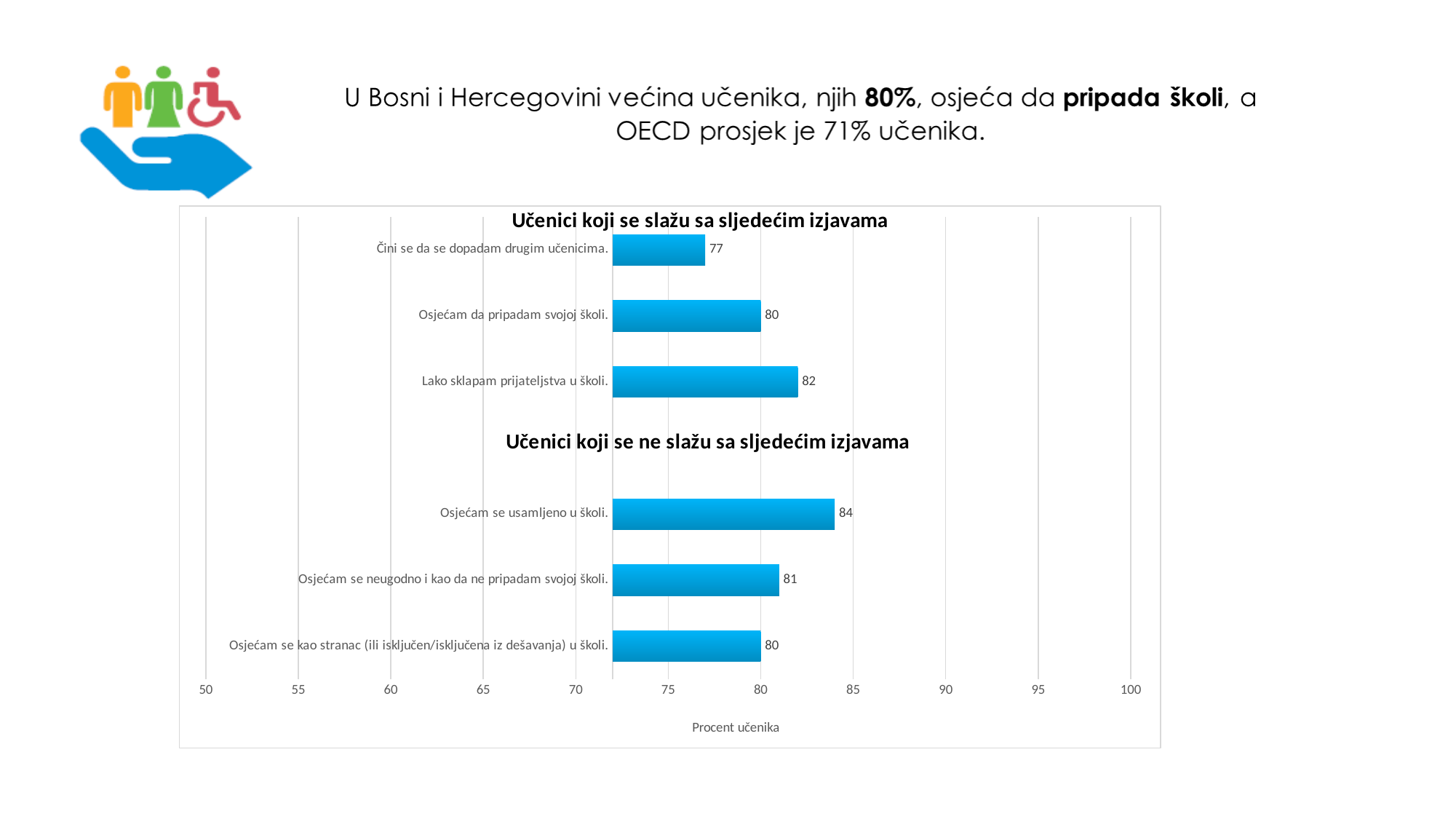
How many bars are plotted in the chart? 6 Which statement has the lowest value? Čini se da se dopadam drugim učenicima. What is the difference between the values for "Osjećam se usamljeno u školi." and "Čini se da se dopadam drugim učenicima."? 7 What is the value for "Osjećam se usamljeno u školi."? 84 Which statement has the highest value? Osjećam se usamljeno u školi. What is the value for "Osjećam da pripadam svojoj školi."? 80 What is the value for "Čini se da se dopadam drugim učenicima."? 77 Is the value for "Lako sklapam prijateljstva u školi." greater or less than 80? greater What kind of chart is shown on the slide? bar chart What is the value for "Osjećam se neugodno i kao da ne pripadam svojoj školi."? 81 Which is larger: the value for "Lako sklapam prijateljstva u školi." or for "Osjećam se neugodno i kao da ne pripadam svojoj školi."? Lako sklapam prijateljstva u školi. What is the label of the horizontal axis? Procent učenika